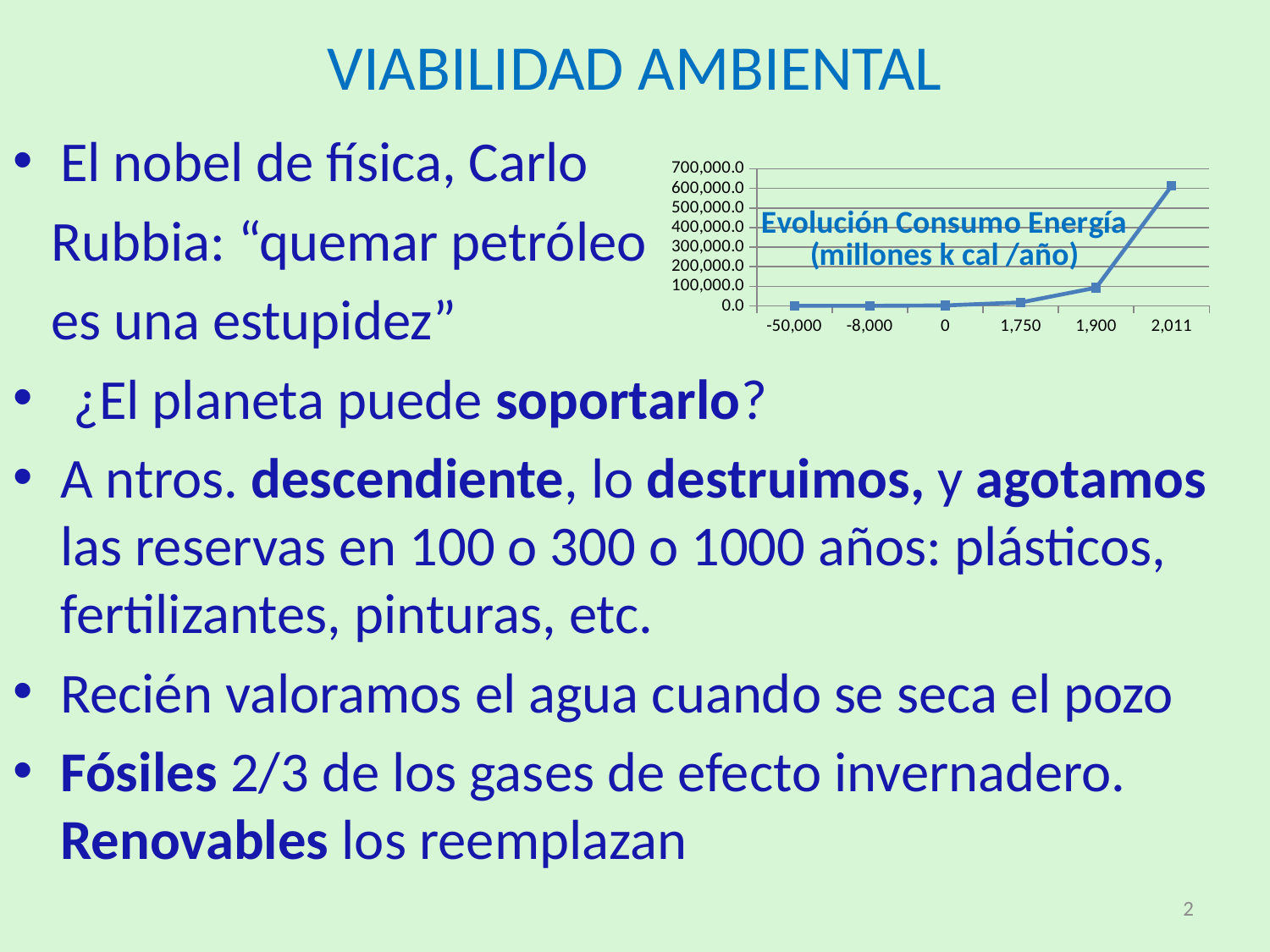
Which x-axis category has the highest value in the chart? 2,011 How many points are plotted along the x axis of the chart? 6 Which has a larger value, 0 or 1,900? 1,900 What is the title of the chart on the slide? Evolución Consumo Energía (millones k cal /año) Is the value for 1,900 greater or less than 200,000.0? less What is the first (leftmost) category on the x axis of the chart? -50,000 What kind of chart is shown on the slide? line chart What is the highest tick value shown on the y axis of the chart? 700,000.0 Is the value for 1,750 greater or less than 100,000.0? less Is the value for 2,011 greater or less than 500,000.0? greater Which has a larger value, 1,900 or 2,011? 2,011 Do the values rise or fall moving from left to right along the x axis? rise